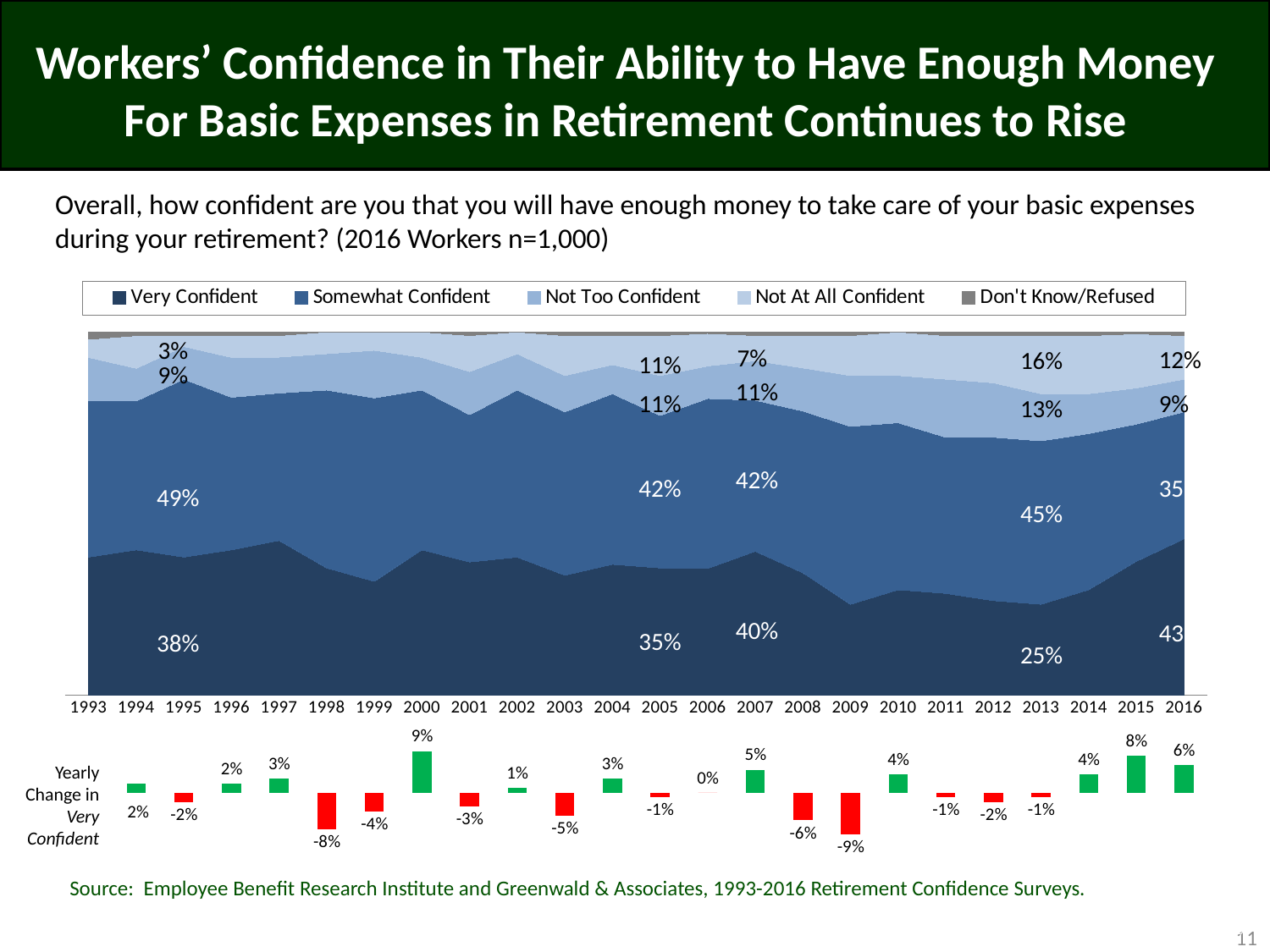
In the bottom chart, which year has the lowest yearly change in Very Confident? 2009 In the top chart, what percentage of workers were Not At All Confident in 2013? 16% In the top chart, what is the difference between the Very Confident share in 2007 and in 2013? 15 percentage points In the top chart, what percentage of workers were Somewhat Confident in 2005? 42% In the top chart, what percentage of workers were Very Confident in 2007? 40% What kind of chart is the bottom chart labelled 'Yearly Change in Very Confident'? Bar chart In the bottom chart, which year has the largest yearly change in Very Confident? 2000 In the top chart, how many series does the legend list? 5 In the bottom chart, which is larger: the yearly change in 2007 or in 2010? 2007 How many years are shown on the x axis of the top chart? 24 What kind of chart is the top chart showing confidence levels from 1993 to 2016? Stacked area chart In the bottom chart, what is the yearly change in Very Confident for 2015? 8%